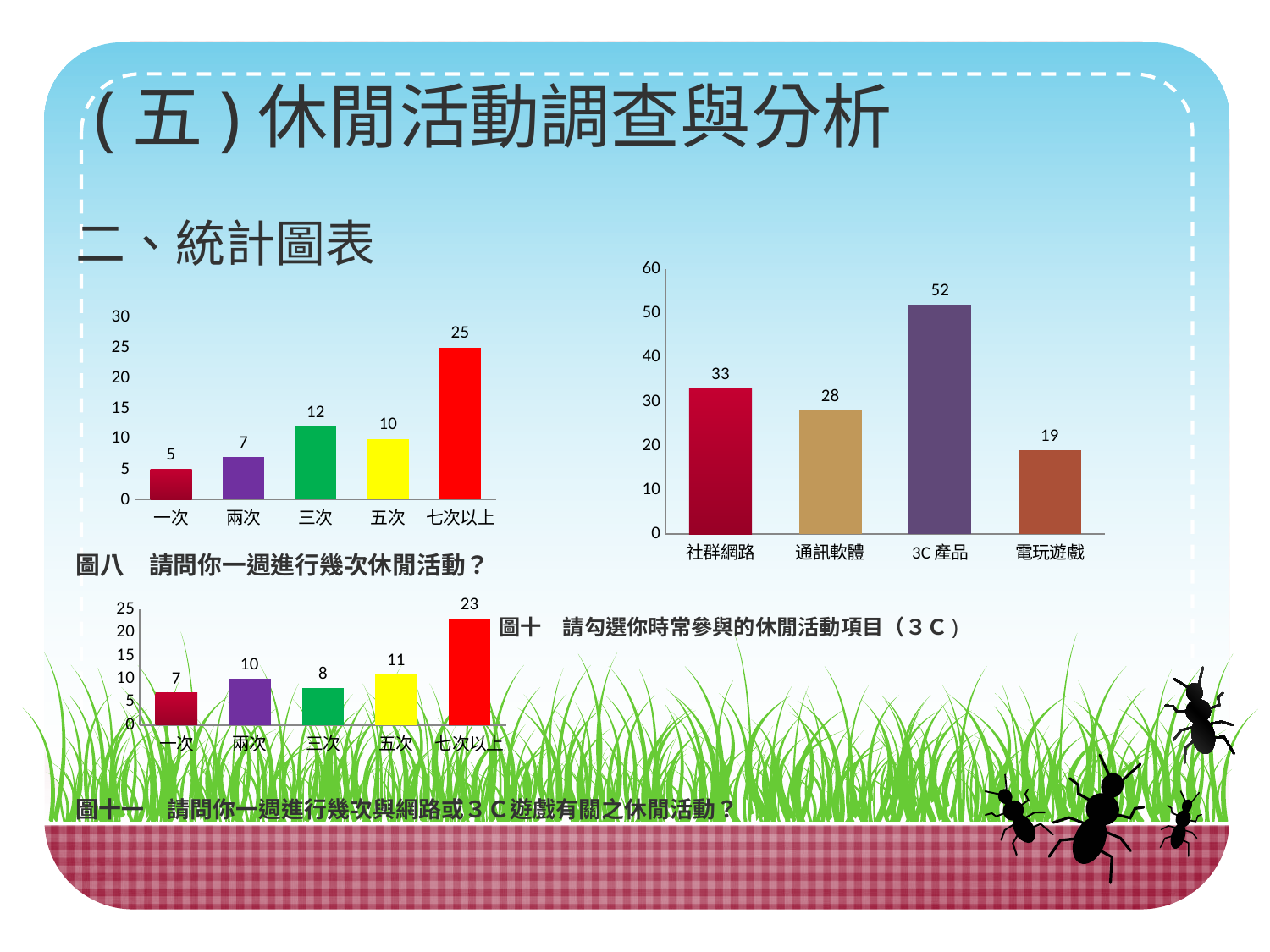
In the chart captioned 圖八 (top-left), which category has the lowest value? 一次 In the chart captioned 圖十 (right), what kind of chart is shown? Bar chart In the chart captioned 圖八 (top-left), what is the difference between the values for 三次 and 五次? 2 In the chart captioned 圖十 (right), what is the difference between the values for 3C 產品 and 電玩遊戲? 33 In the chart captioned 圖十 (right), what is the value for 通訊軟體? 28 In the chart captioned 圖十一 (bottom-left), which category has the highest value? 七次以上 In the chart captioned 圖八 (top-left), what is the value for 七次以上? 25 In the chart captioned 圖十一 (bottom-left), which is larger, the value for 兩次 or the value for 三次? 兩次 In the chart captioned 圖十 (right), which is larger, the value for 社群網路 or the value for 通訊軟體? 社群網路 In the chart captioned 圖十一 (bottom-left), what is the value for 五次? 11 In the chart captioned 圖八 (top-left), how many categories are shown on the x axis? 5 In the chart captioned 圖十 (right), which category has the highest value? 3C 產品